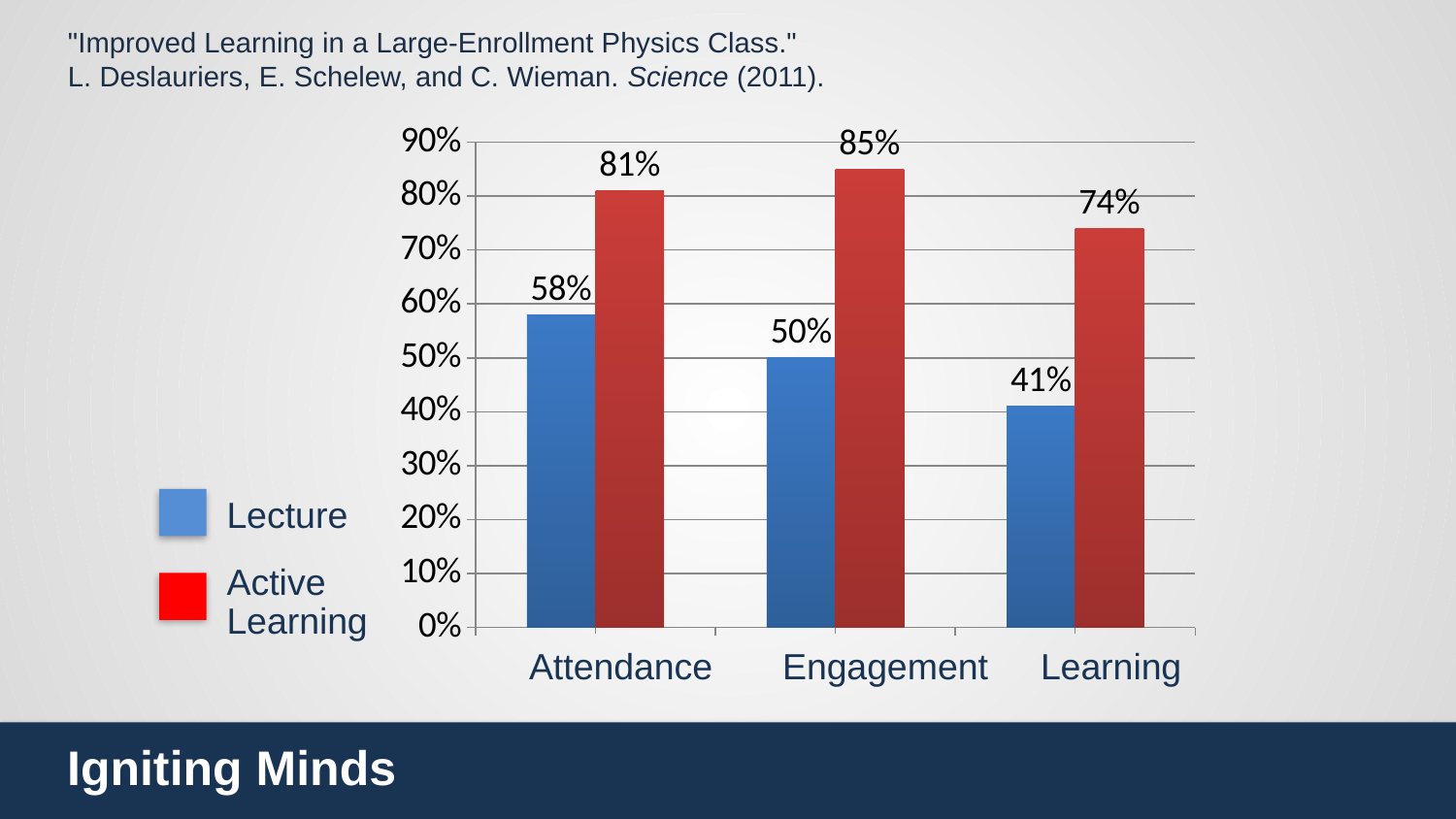
What is the difference between the Active Learning and Lecture values for Learning? 33% How many categories are shown on the x axis? 3 Which category has the highest Active Learning value? Engagement What is the Active Learning value for Learning? 74% What kind of chart is shown on the slide? Bar chart How many series does the legend list? 2 What is the difference between the Active Learning and Lecture values for Attendance? 23% Which is larger for Engagement, the Lecture value or the Active Learning value? Active Learning Which category has the lowest Lecture value? Learning What is the Active Learning value for Engagement? 85% What is the Lecture value for Attendance? 58% What is the Lecture value for Learning? 41%